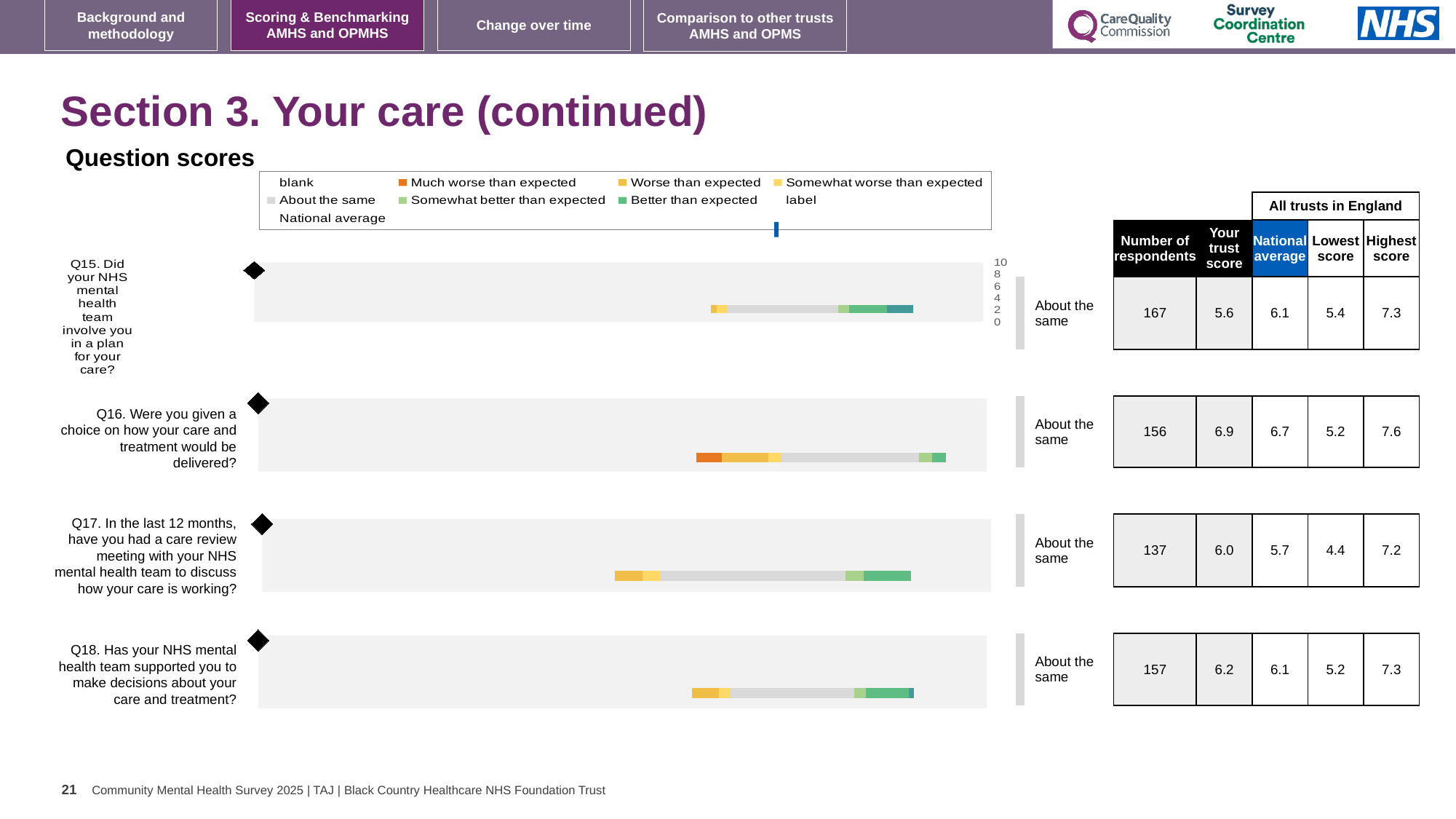
What colour in the legend represents 'Much worse than expected'? orange How many questions (Q15 to Q18) have a bar plotted on the slide? 4 What kind of chart is used to show the question scores for Q15 to Q18? bar chart Which question has the highest 'Your trust score' in the table? Q16 What colour in the legend represents 'About the same'? grey What comparison label is shown next to the bar for Q16? About the same In the table, what is the highest score across all trusts in England for Q16? 7.6 Which question has the lowest number of respondents in the table? Q17 For Q15, which is larger: 'Your trust score' or the national average? National average In the table, what is the number of respondents for Q16? 156 For Q18, what is the difference between 'Your trust score' and the national average? 0.1 In the table, what is 'Your trust score' for Q17? 6.0